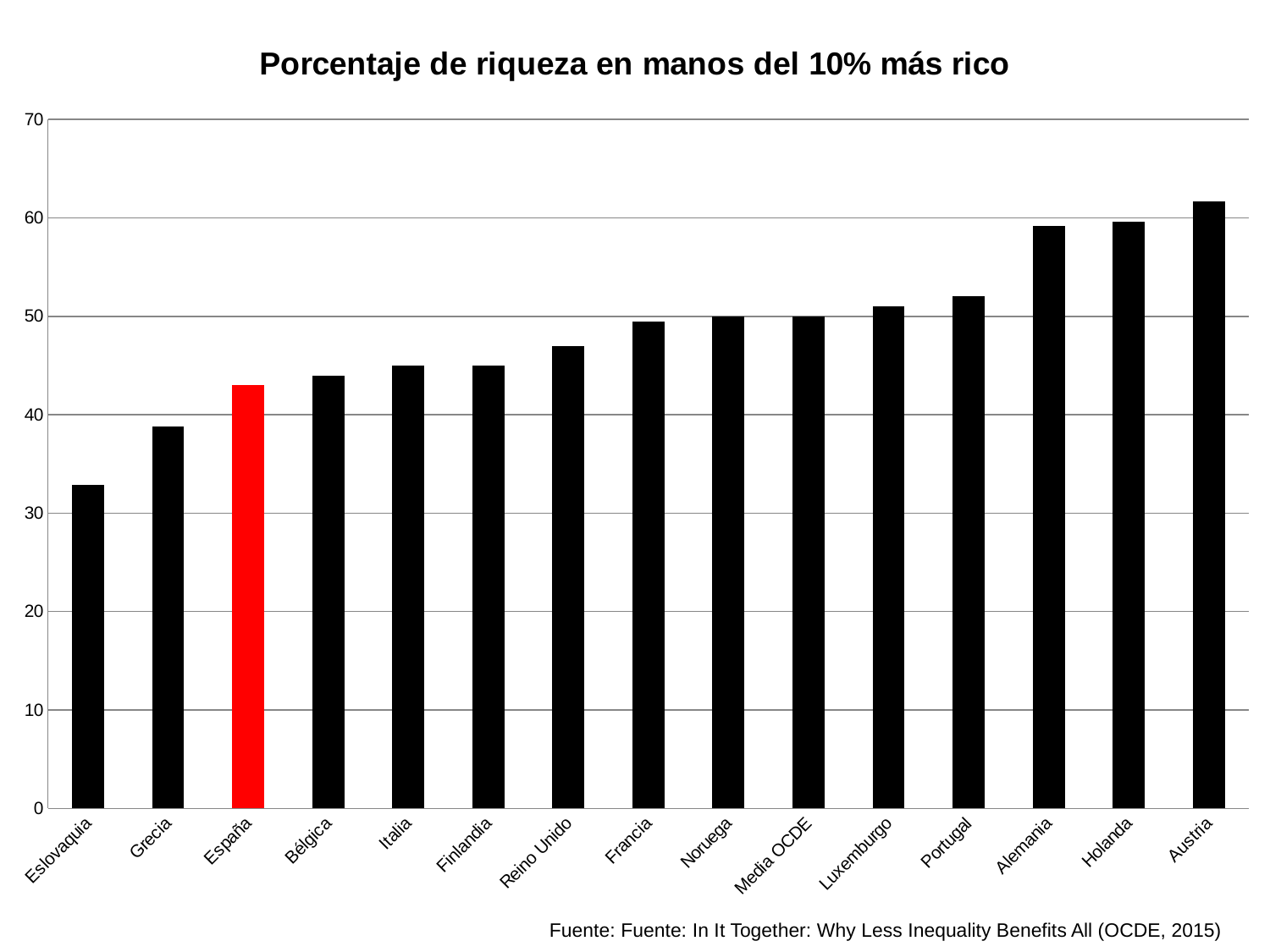
Is the value for España greater or less than 50? less Which country has the lowest percentage of wealth held by the richest 10%? Eslovaquia Which is larger, the value for Holanda or the value for Grecia? Holanda Is the value for Alemania greater or less than 50? greater Is the value for Grecia greater or less than 40? less Do the values generally rise or fall from left to right along the x axis? rise Which country's bar is coloured red? España How many categories are shown on the x axis? 15 What kind of chart is shown on the slide? bar chart Which country has the highest percentage of wealth held by the richest 10%? Austria